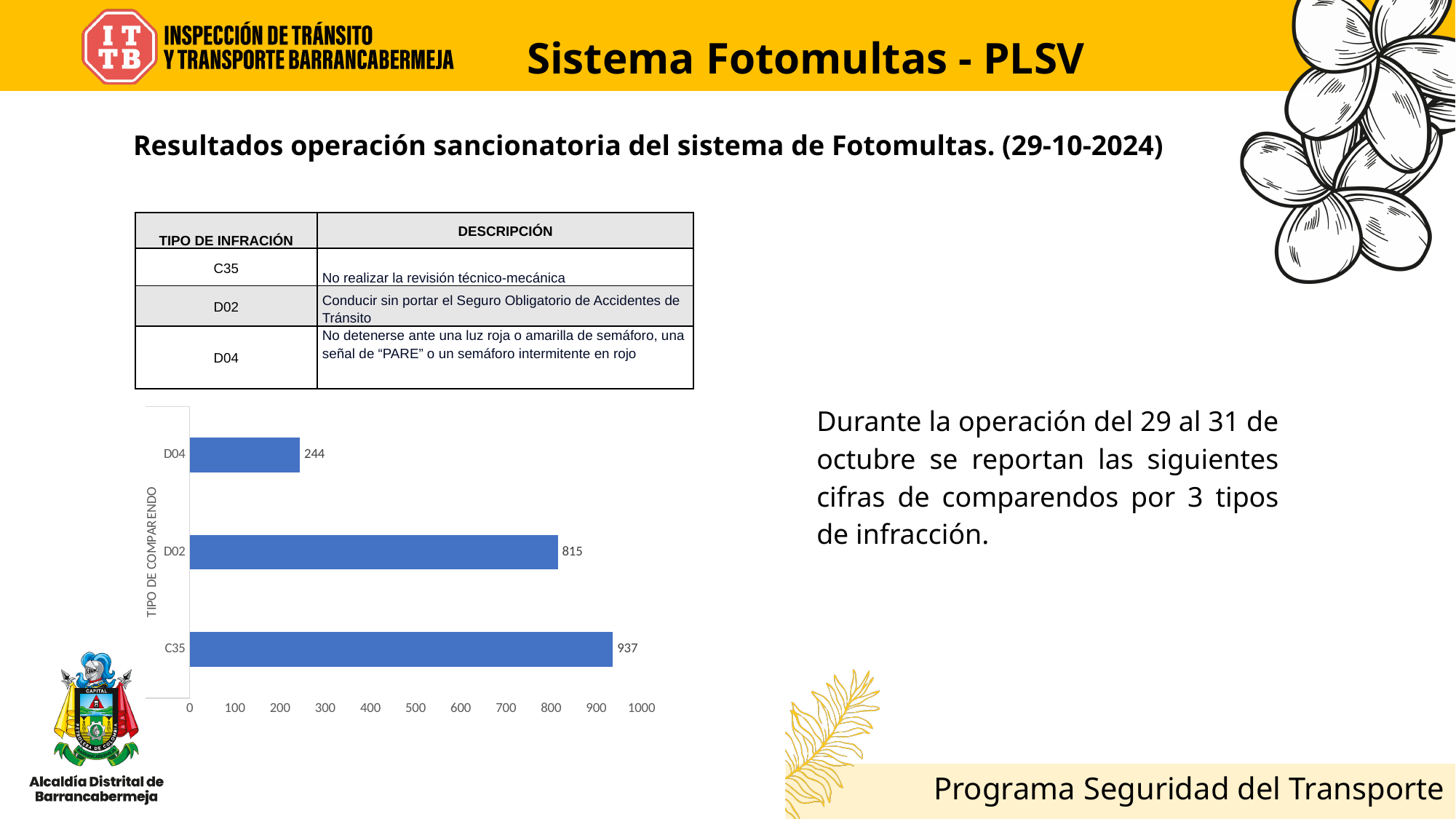
Which is larger, the value for D02 or the value for D04? D02 What is the value for C35 in the bar chart? 937 Is the value for C35 greater or less than 900? greater Which category has the highest value in the bar chart? C35 What is the value for D04 in the bar chart? 244 What is the difference between the values for C35 and D02? 122 What kind of chart is shown on the slide? bar chart Which category has the lowest value in the bar chart? D04 What is the label of the vertical axis of the bar chart? TIPO DE COMPARENDO How many categories are shown in the bar chart? 3 What is the value for D02 in the bar chart? 815 What is the difference between the values for D02 and D04? 571